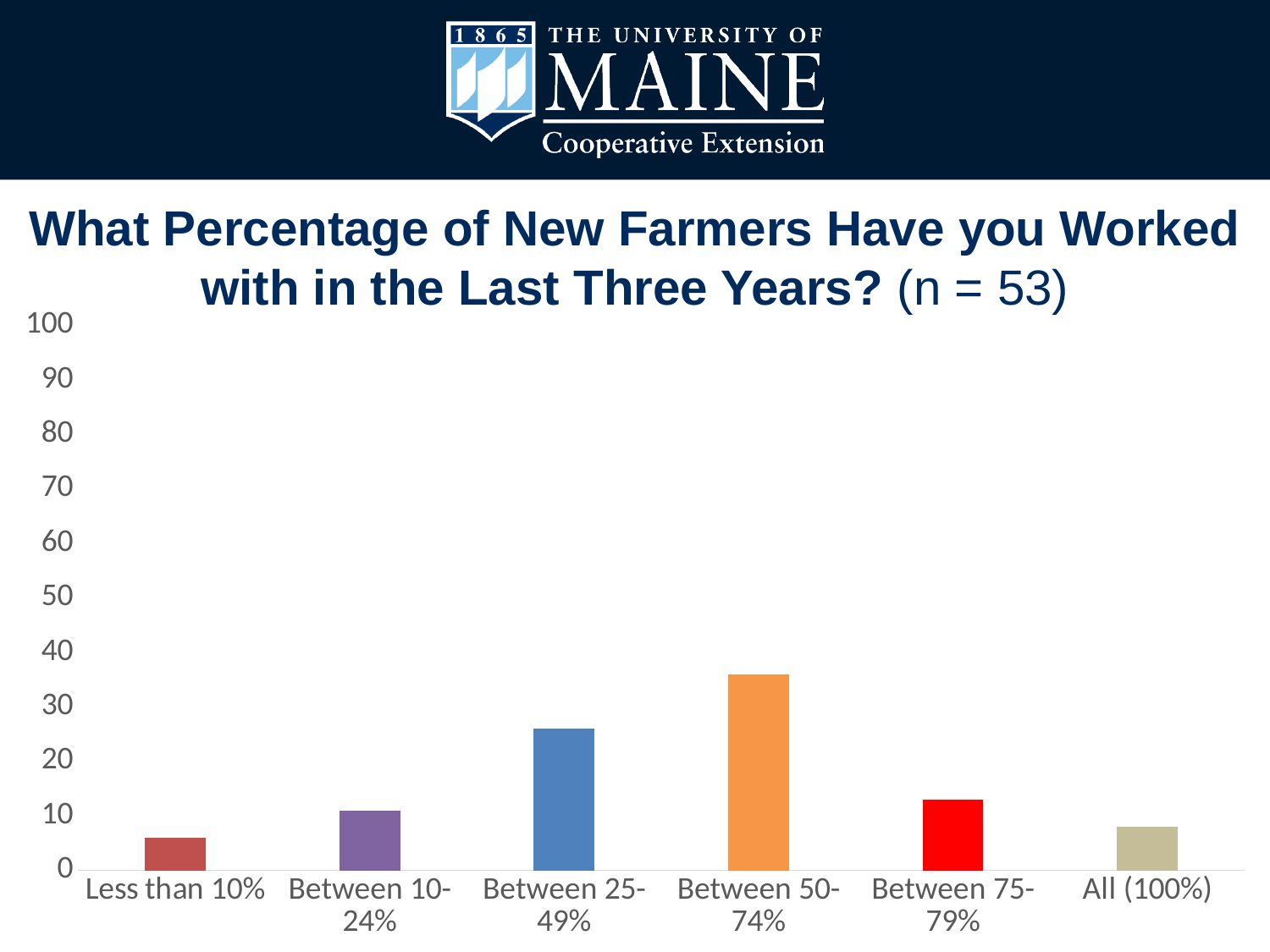
How many categories are shown on the x axis of the chart? 6 What is the highest value shown on the y axis of the chart? 100 Which category has the highest bar in the chart? Between 50-74% What kind of chart is shown on the slide? bar chart Is the value for All (100%) greater or less than 10? less Which is larger, the value for Between 50-74% or the value for Between 10-24%? Between 50-74% Is the value for Less than 10% greater or less than 10? less Is the value for Between 50-74% greater or less than 30? greater Which is larger, the value for Between 25-49% or the value for Between 75-79%? Between 25-49% What is the sample size (n) given in the chart title? 53